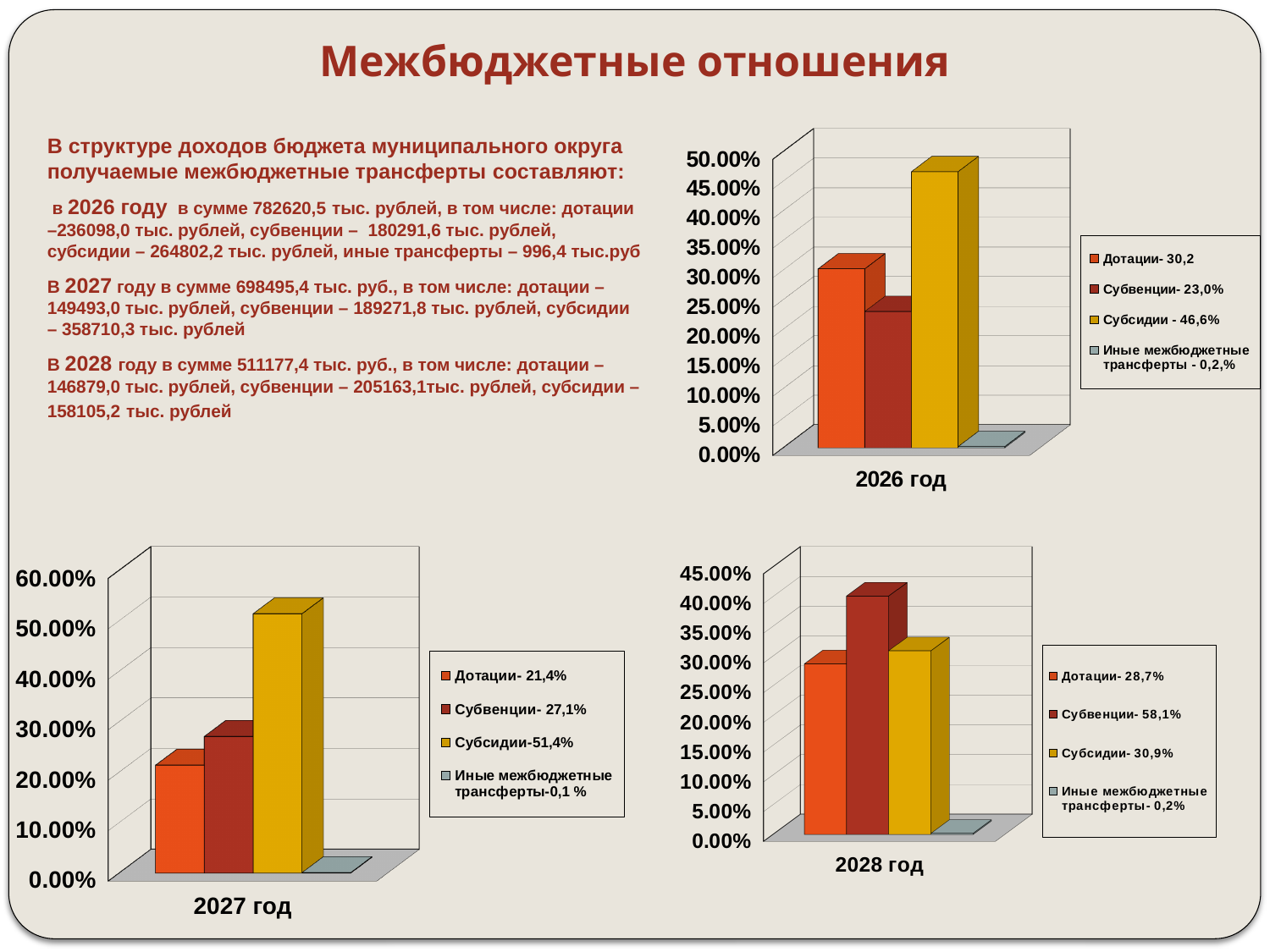
In the 2026 год chart, which category has the highest value? Субсидии How many series does the legend of the 2028 год chart list? 4 In the 2028 год chart, which category has the highest value? Субвенции In the 2026 год chart, which category has the lowest value? Иные межбюджетные трансферты In the 2027 год chart, which is larger, Субвенции or Дотации? Субвенции What kind of chart is the 2026 год chart? bar chart In the 2028 год chart, what value does the legend give for Субсидии? 30,9% In the 2026 год chart, is the value for Дотации greater or less than 25%? greater In the 2027 год chart, what value does the legend give for Дотации? 21,4% In the 2026 год chart, what value does the legend give for Субвенции? 23,0% In the 2026 год chart, what value does the legend give for Субсидии? 46,6% In the 2027 год chart, what is the difference between Субсидии and Дотации? 30,0%